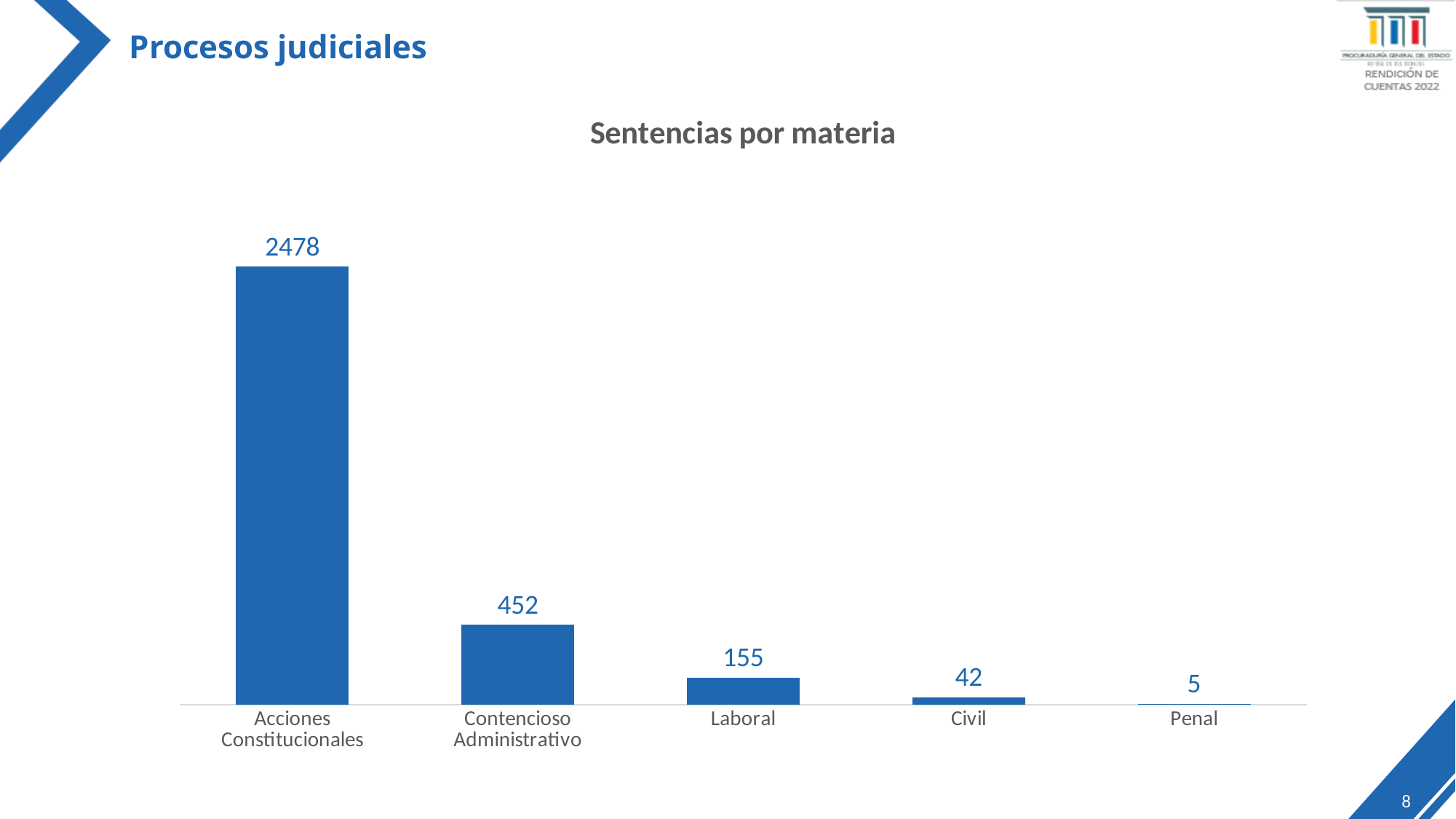
What is the value for Civil? 42 How many categories are shown in the chart? 5 What is the value for Penal? 5 What is the value for Laboral? 155 Which category has the highest value? Acciones Constitucionales What is the value for Contencioso Administrativo? 452 What kind of chart is shown on the slide? Bar chart What is the title of the chart? Sentencias por materia Which is larger, the value for Laboral or the value for Civil? Laboral Which category has the lowest value? Penal What is the value for Acciones Constitucionales? 2478 What is the difference between the values for Acciones Constitucionales and Contencioso Administrativo? 2026